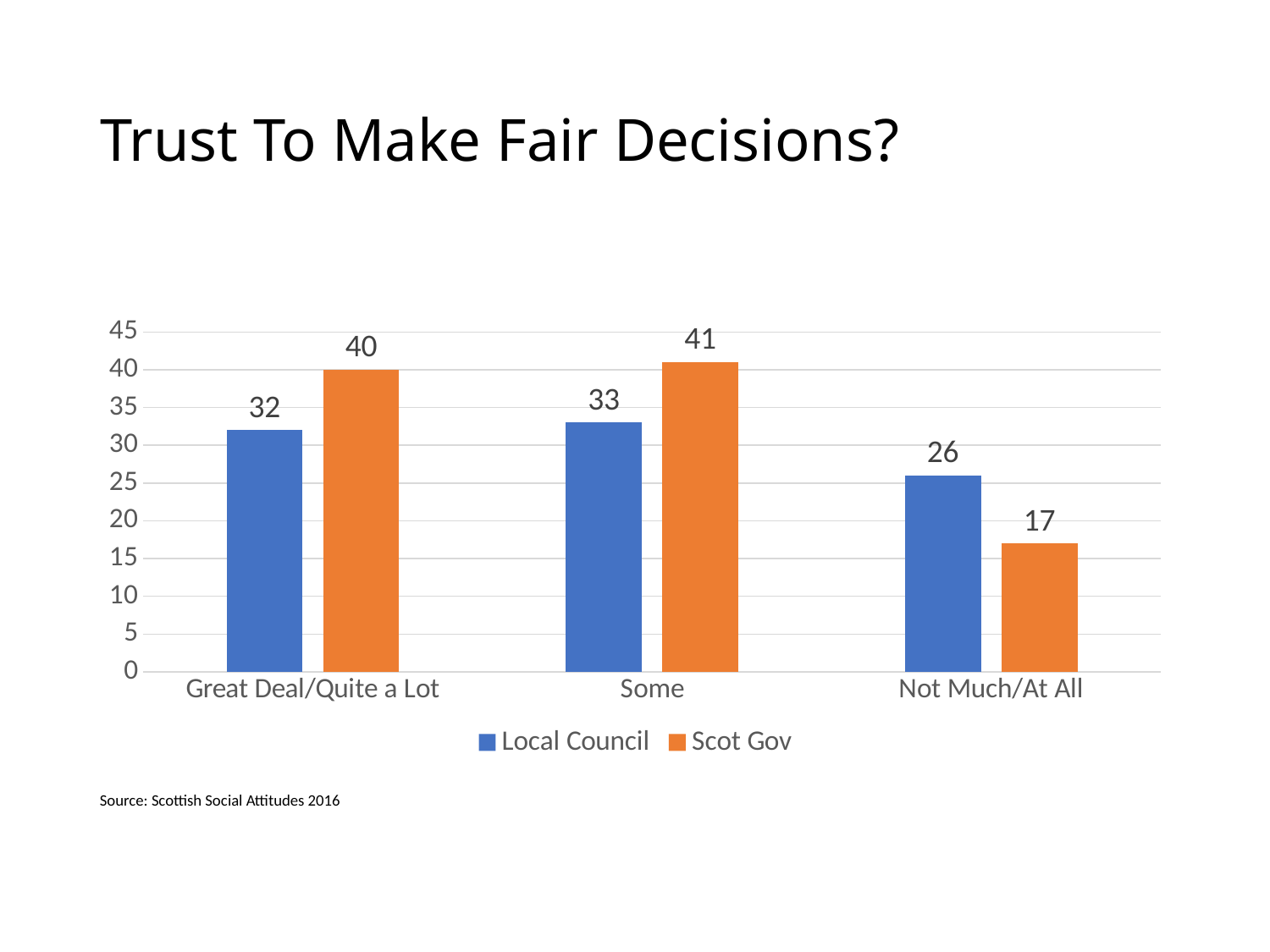
What is the difference between the Scot Gov and Local Council values for Great Deal/Quite a Lot? 8 What is the Local Council value for Great Deal/Quite a Lot? 32 What is the Scot Gov value for Not Much/At All? 17 What is the Scot Gov value for Some? 41 Which category has the highest Scot Gov value? Some What kind of chart is shown on the slide? Bar chart For Not Much/At All, which series has the larger value, Local Council or Scot Gov? Local Council How many series does the legend list? 2 Which category has the lowest Local Council value? Not Much/At All Which series is shown in orange? Scot Gov What is the difference between the Local Council and Scot Gov values for Not Much/At All? 9 How many categories are shown on the x axis? 3